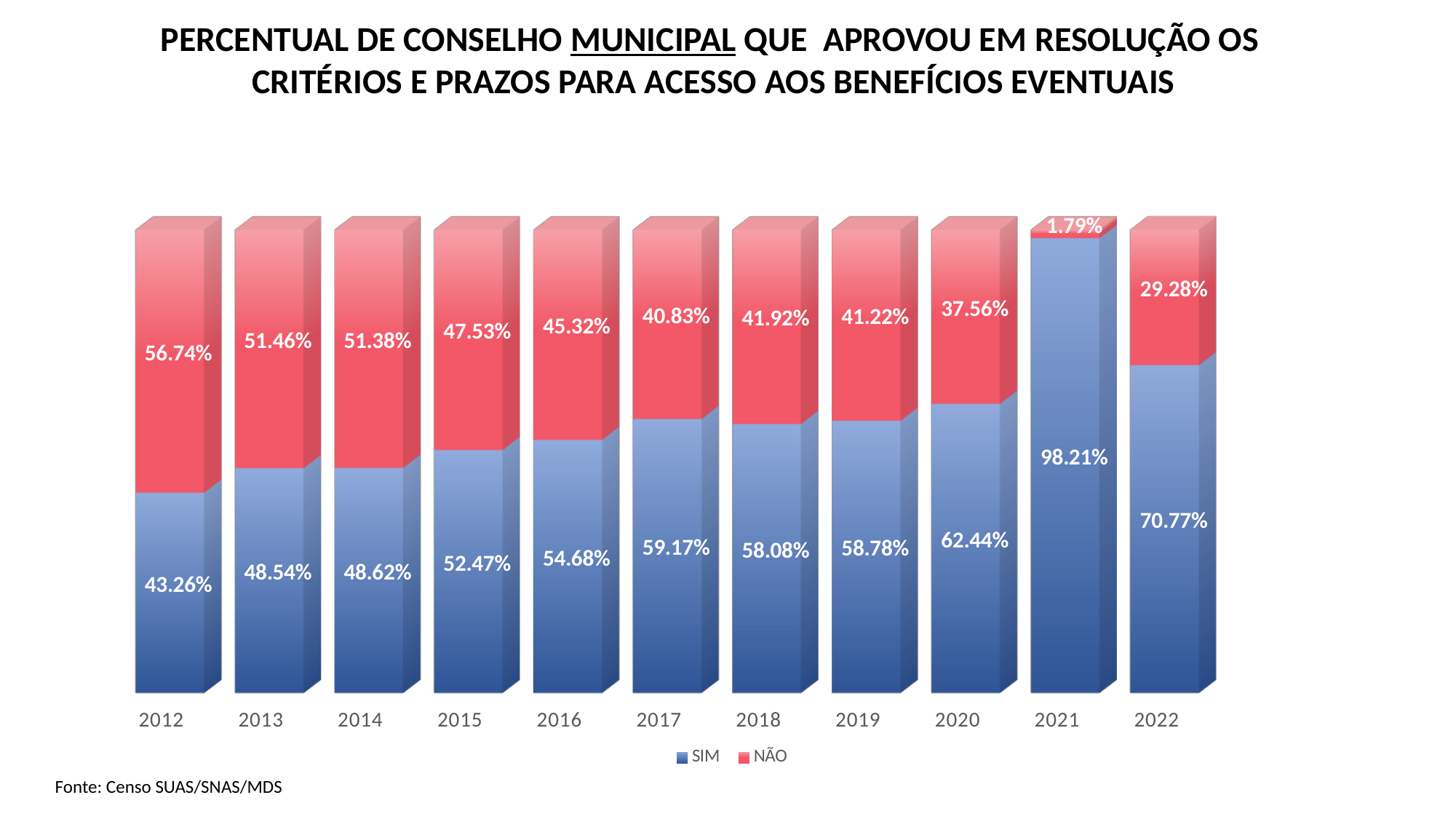
What is the SIM value for 2012? 43.26% How many years are shown on the x axis? 11 How many series does the legend list? 2 What is the total of the stacked bar for 2012? 100% What is the NÃO value for 2022? 29.28% Which year has the larger SIM value, 2018 or 2019? 2019 In which year is the NÃO value highest? 2012 What kind of chart is shown on the slide? Stacked bar chart What is the difference between the SIM value in 2022 and the SIM value in 2020? 8.33 percentage points In which year is the NÃO value lowest? 2021 In which year is the SIM value highest? 2021 What is the SIM value for 2021? 98.21%